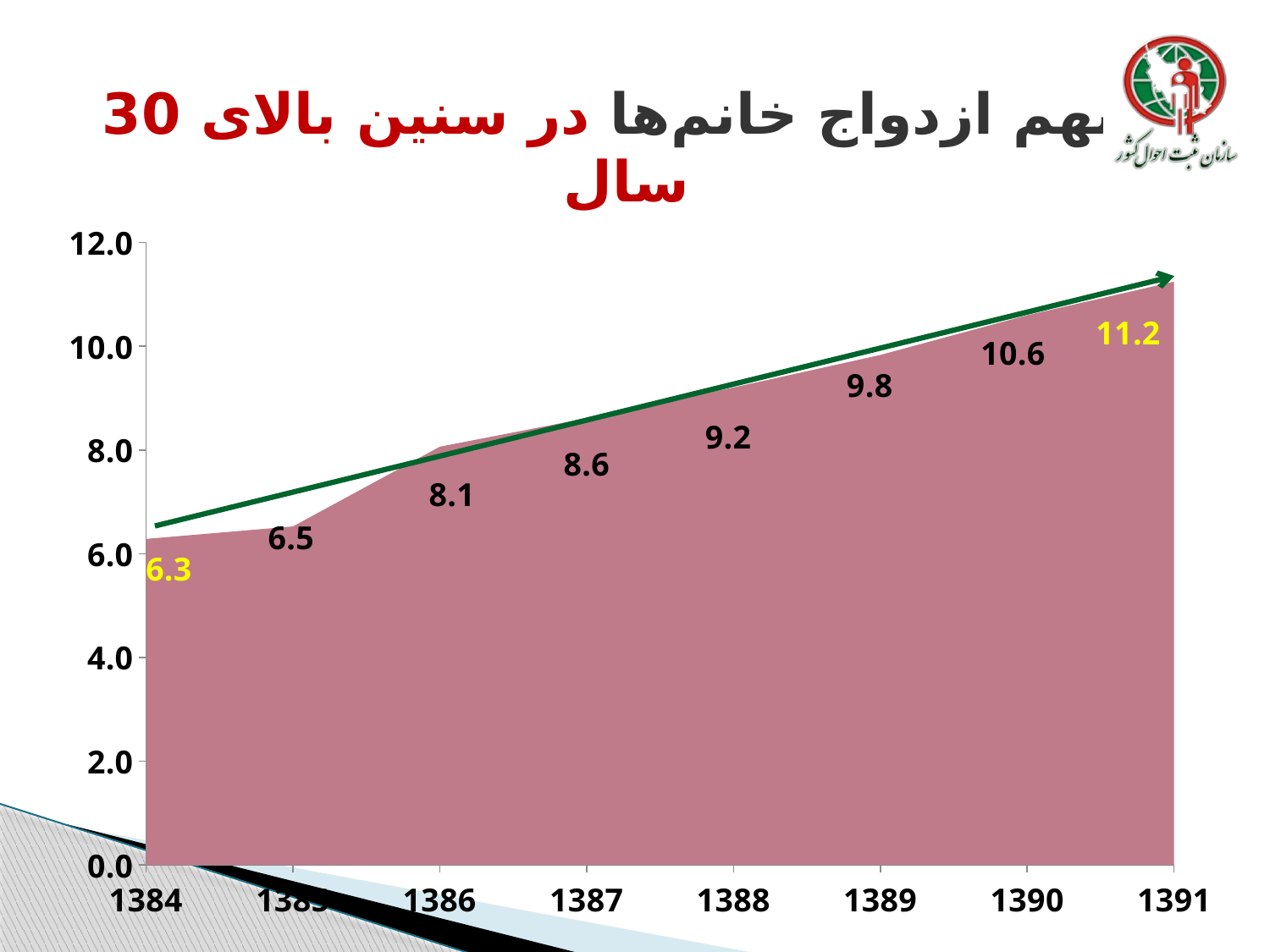
How many years are shown on the x axis? 8 What is the difference between the values for 1390 and 1389? 0.8 Which year has the lowest value? 1384 What is the value for 1384? 6.3 Which is larger, the value for 1387 or the value for 1389? 1389 Which year has the highest value? 1391 What is the value for 1391? 11.2 What is the value for 1386? 8.1 What kind of chart is this? Area chart What is the difference between the values for 1391 and 1384? 4.9 Do the values rise or fall from 1384 to 1391? Rise What is the value for 1388? 9.2